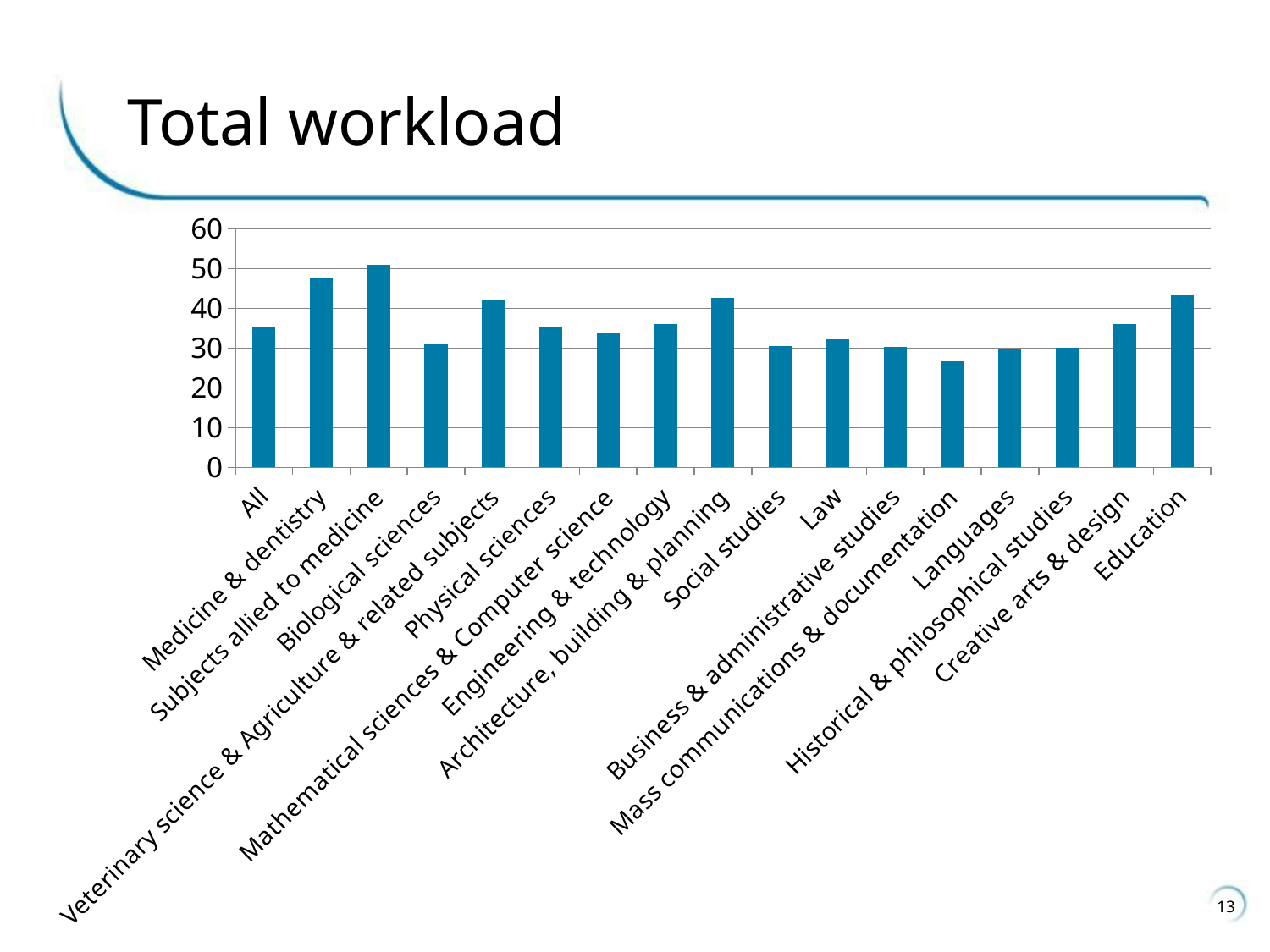
Is the value for Education greater or less than 40? greater Which is larger, the value for Medicine & dentistry or the value for Education? Medicine & dentistry What is the highest value shown on the y axis? 60 What kind of chart is shown on the slide? bar chart Which category has the lowest value? Mass communications & documentation How many categories are plotted on the x axis? 17 What is the title of the slide? Total workload Is the value for Mass communications & documentation greater or less than 30? less Is the value for Medicine & dentistry greater or less than 50? less Which is larger, the value for Architecture, building & planning or the value for Social studies? Architecture, building & planning Which category has the highest value? Subjects allied to medicine